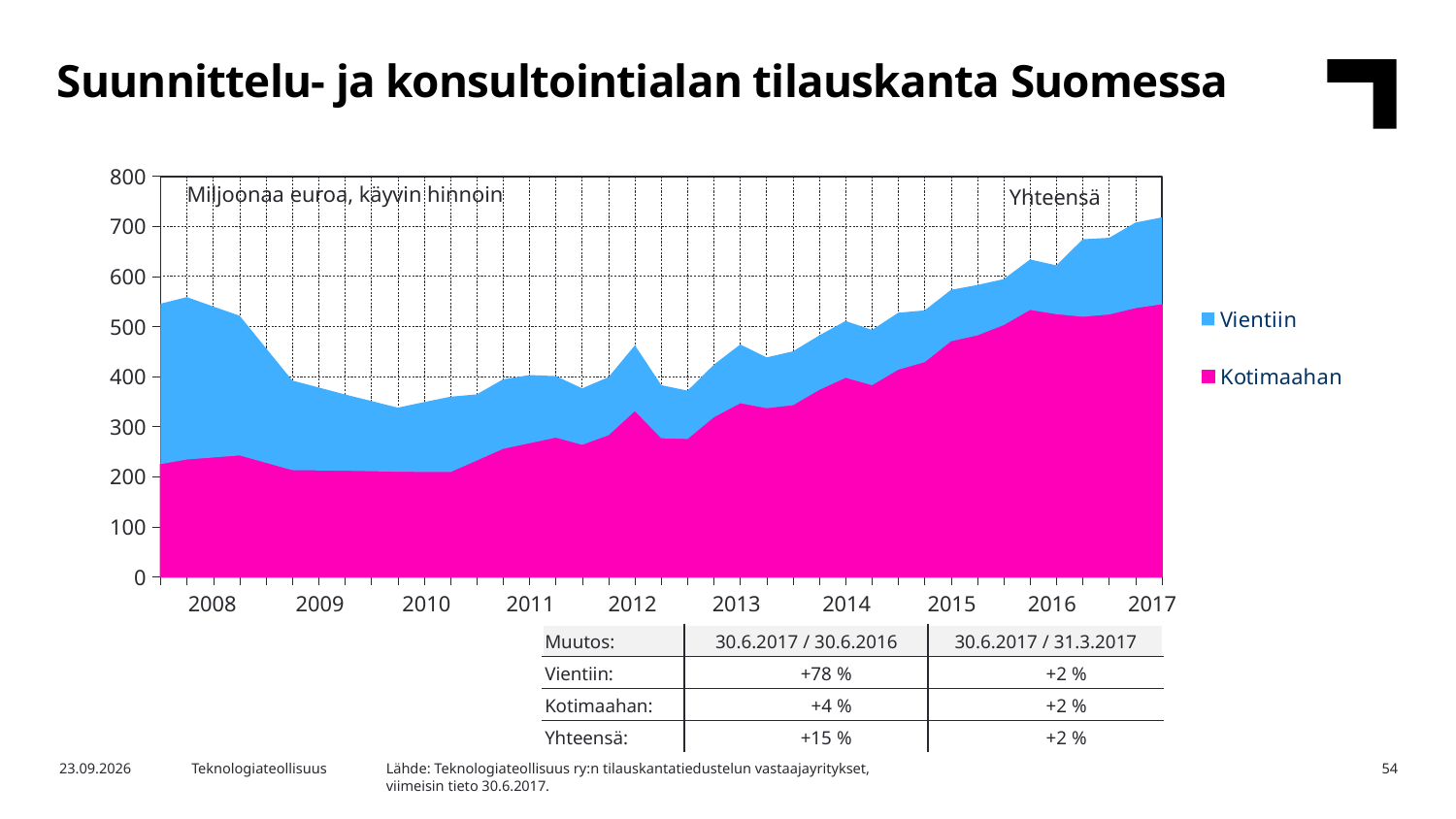
Is the total (Yhteensä) value larger in 2017 or in 2010? 2017 What kind of chart is shown on the slide? Stacked area chart Does the Kotimaahan series rise or fall between 2013 and 2017? rise Is the Kotimaahan value in 2010 greater or less than 300? less Is the total (Yhteensä) value at the end of 2017 greater or less than 700? greater What are the two series named in the chart legend? Vientiin and Kotimaahan How many series does the chart legend list? 2 According to the table below the chart, what is the change in Vientiin for 30.6.2017 / 30.6.2016? +78 % In which year on the x axis does the total (Yhteensä) reach its highest level? 2017 Is the total (Yhteensä) value in 2010 greater or less than 400? less What unit is stated in the label at the top left of the chart? Miljoonaa euroa, käyvin hinnoin